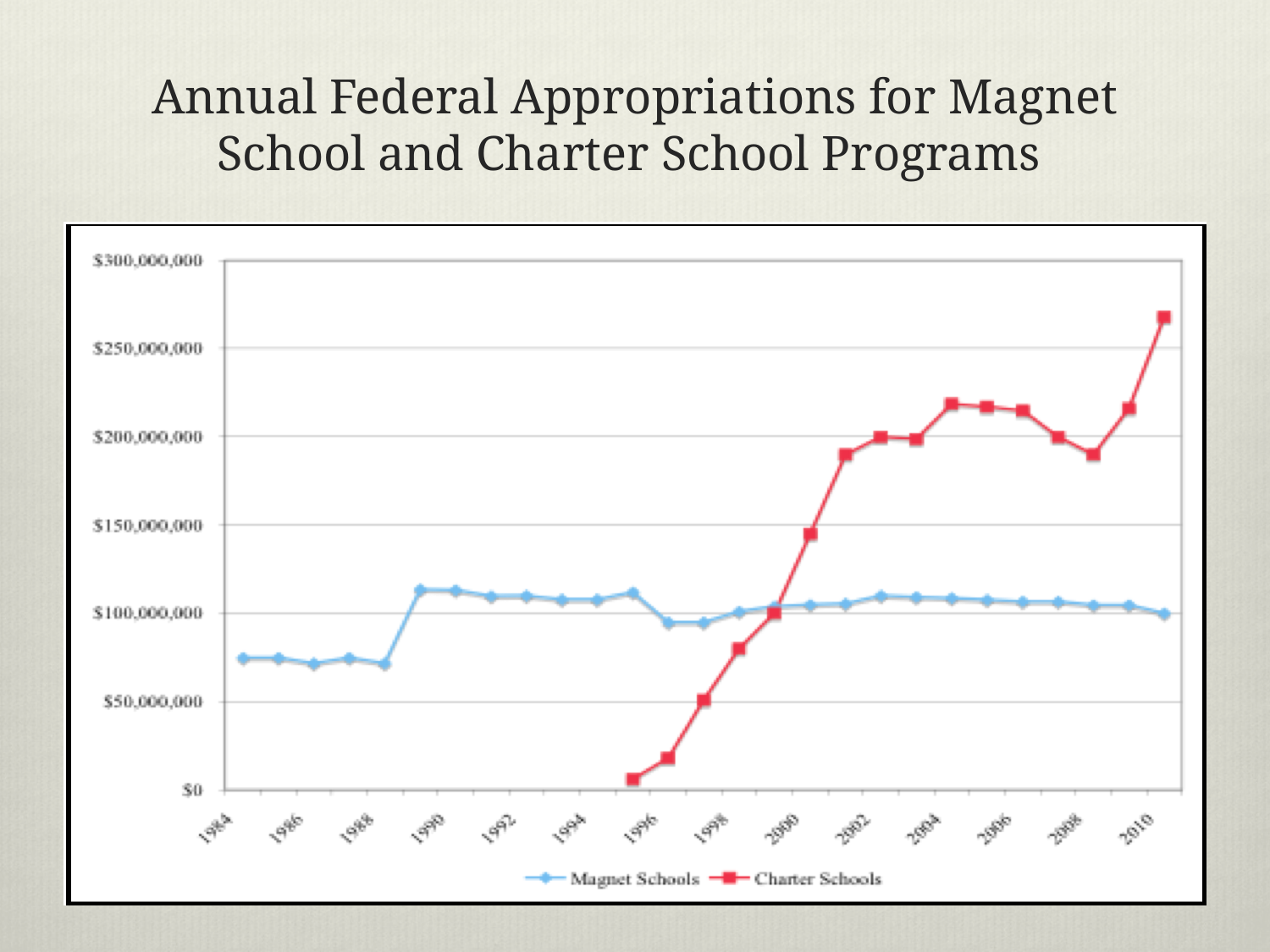
What is the title of the slide? Annual Federal Appropriations for Magnet School and Charter School Programs What kind of chart is shown on the slide? Line chart In 2010, which series has the larger value, Magnet Schools or Charter Schools? Charter Schools Is the value for Charter Schools in 2004 greater or less than $200,000,000? greater What are the two series named in the legend? Magnet Schools and Charter Schools In 1996, which series has the larger value, Magnet Schools or Charter Schools? Magnet Schools Is the value for Magnet Schools in 1990 greater or less than $100,000,000? greater Is the value for Magnet Schools in 1984 greater or less than $100,000,000? less How many series does the legend list? 2 In which year does the Charter Schools series reach its highest value? 2010